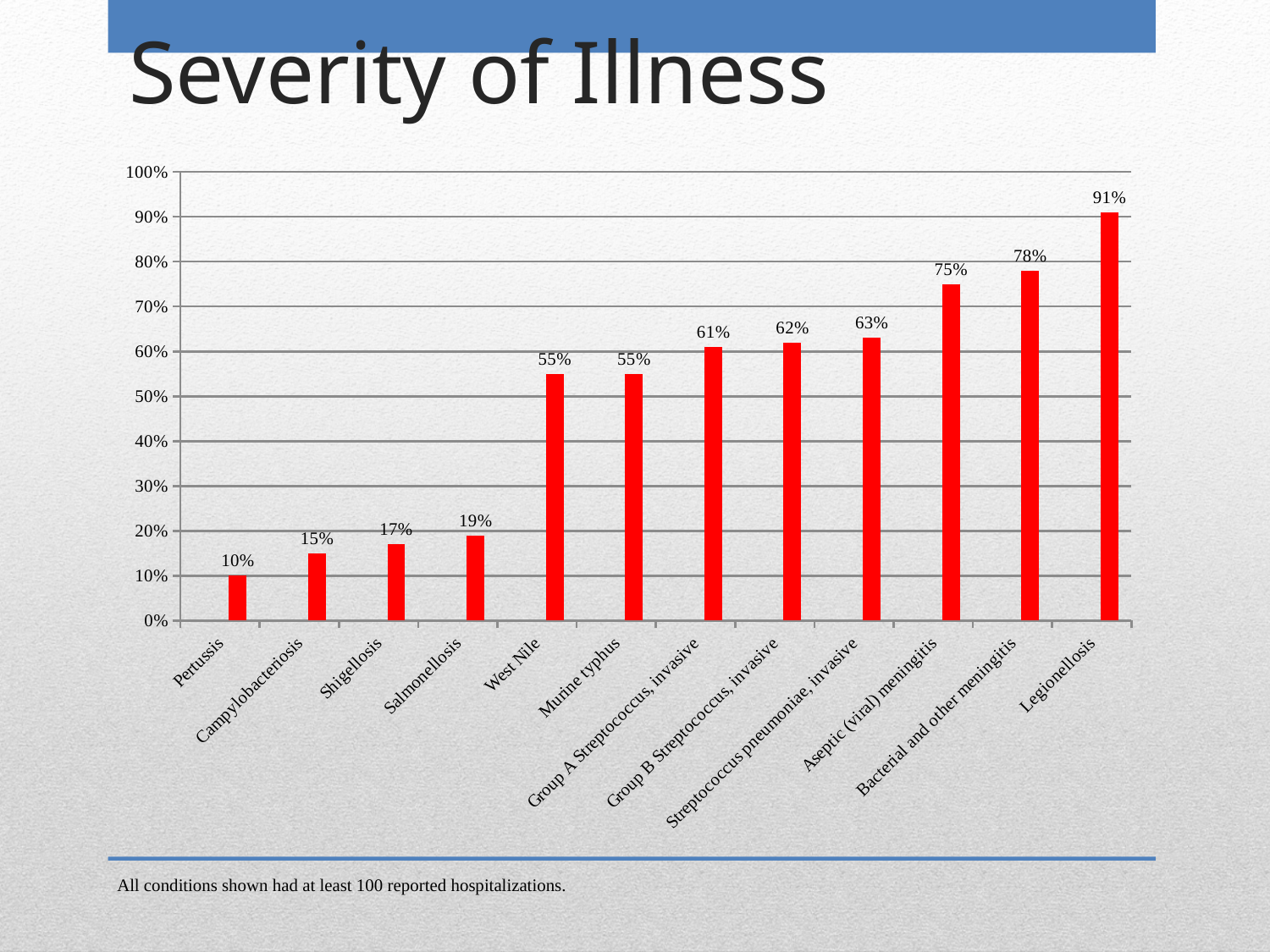
What is the value for Aseptic (viral) meningitis? 75% What is the value for Legionellosis? 91% Which category has the highest value? Legionellosis Which is larger, the value for Shigellosis or the value for West Nile? West Nile What is the value for Pertussis? 10% Which category has the lowest value? Pertussis What kind of chart is shown on the slide? Bar chart What is the difference between the values for Legionellosis and Pertussis? 81% What is the difference between the values for Bacterial and other meningitis and Aseptic (viral) meningitis? 3% What is the value for Salmonellosis? 19% Do the values rise or fall from left to right along the x axis? Rise How many categories are shown on the x axis? 12